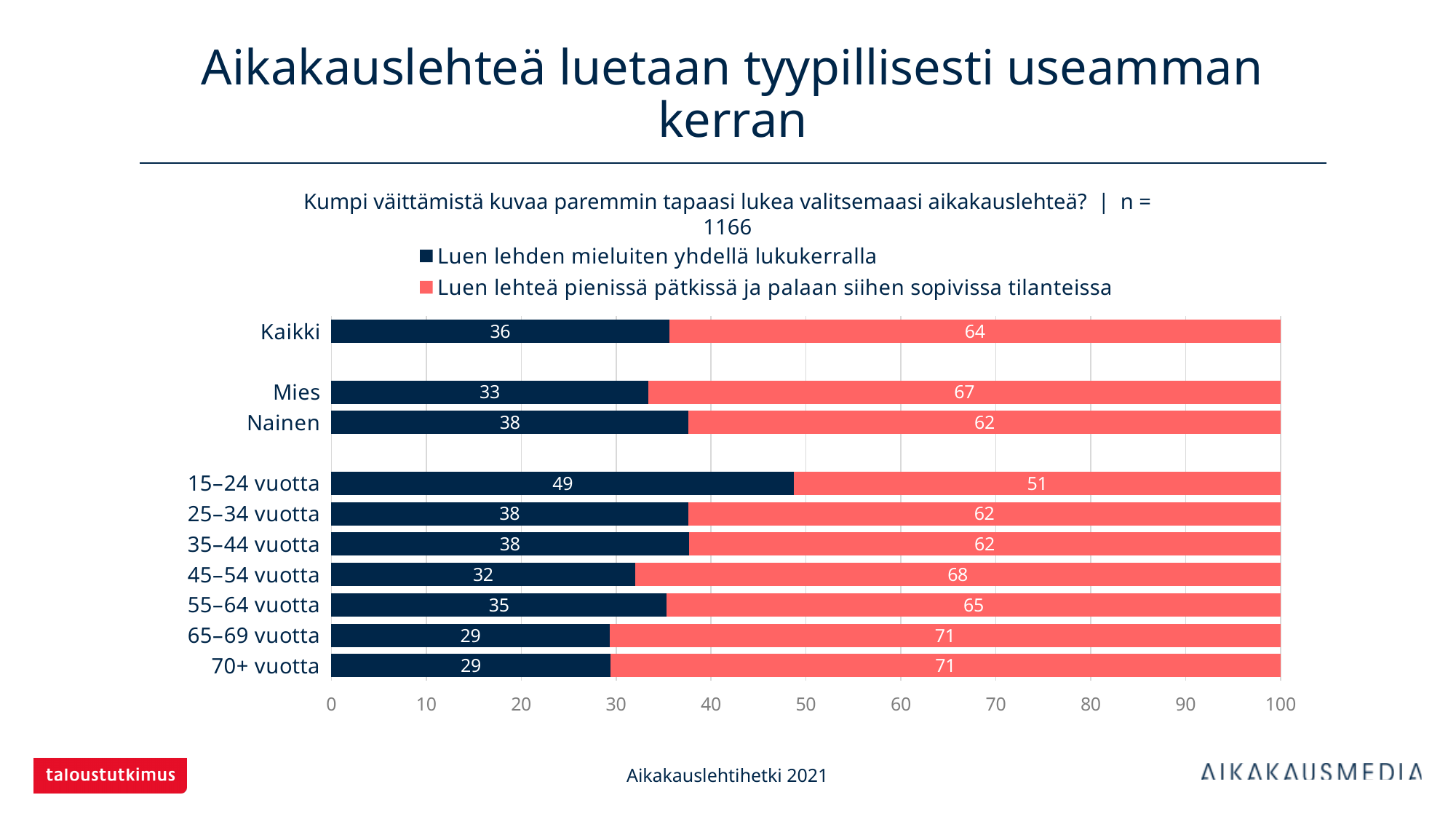
What is the value for "Luen lehteä pienissä pätkissä ja palaan siihen sopivissa tilanteissa" for 45–54 vuotta? 68 Which category has the highest value for "Luen lehden mieluiten yhdellä lukukerralla"? 15–24 vuotta What is the value for "Luen lehden mieluiten yhdellä lukukerralla" for Mies? 33 What is the sample size (n) stated in the chart title? 1166 What kind of chart is shown on the slide? Stacked bar chart Which is larger: the "Luen lehden mieluiten yhdellä lukukerralla" value for 55–64 vuotta or for 65–69 vuotta? 55–64 vuotta What is the difference between the "Luen lehden mieluiten yhdellä lukukerralla" values for Nainen and Mies? 5 What is the value for "Luen lehden mieluiten yhdellä lukukerralla" for Kaikki? 36 Which category has the lowest value for "Luen lehteä pienissä pätkissä ja palaan siihen sopivissa tilanteissa"? 15–24 vuotta What is the total of the stacked bar for 70+ vuotta? 100 How many series does the legend list? 2 How many categories are shown on the y axis of the chart? 10